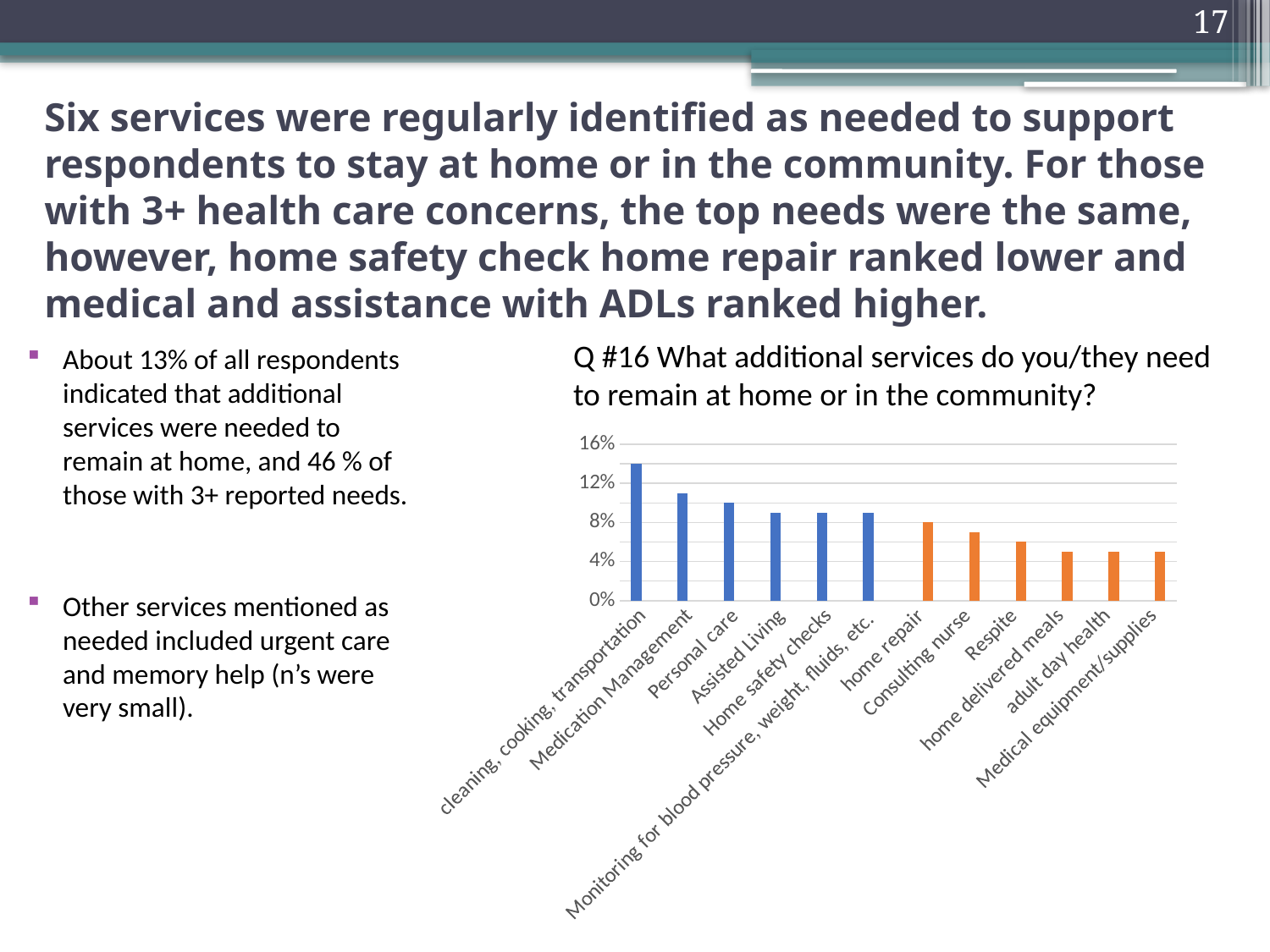
Is the value for Personal care greater or less than 8%? greater Is the value for Medication Management greater or less than 8%? greater Do the bar values rise or fall from left to right along the x axis? fall Which is larger, the value for Respite or the value for cleaning, cooking, transportation? cleaning, cooking, transportation What is the title of the chart? Q #16 What additional services do you/they need to remain at home or in the community? How many service categories are plotted on the chart? 12 Which service has the highest value on the chart? cleaning, cooking, transportation Is the value for cleaning, cooking, transportation greater or less than 12%? greater Which is larger, the value for Medication Management or the value for home repair? Medication Management What kind of chart is shown on the slide? bar chart